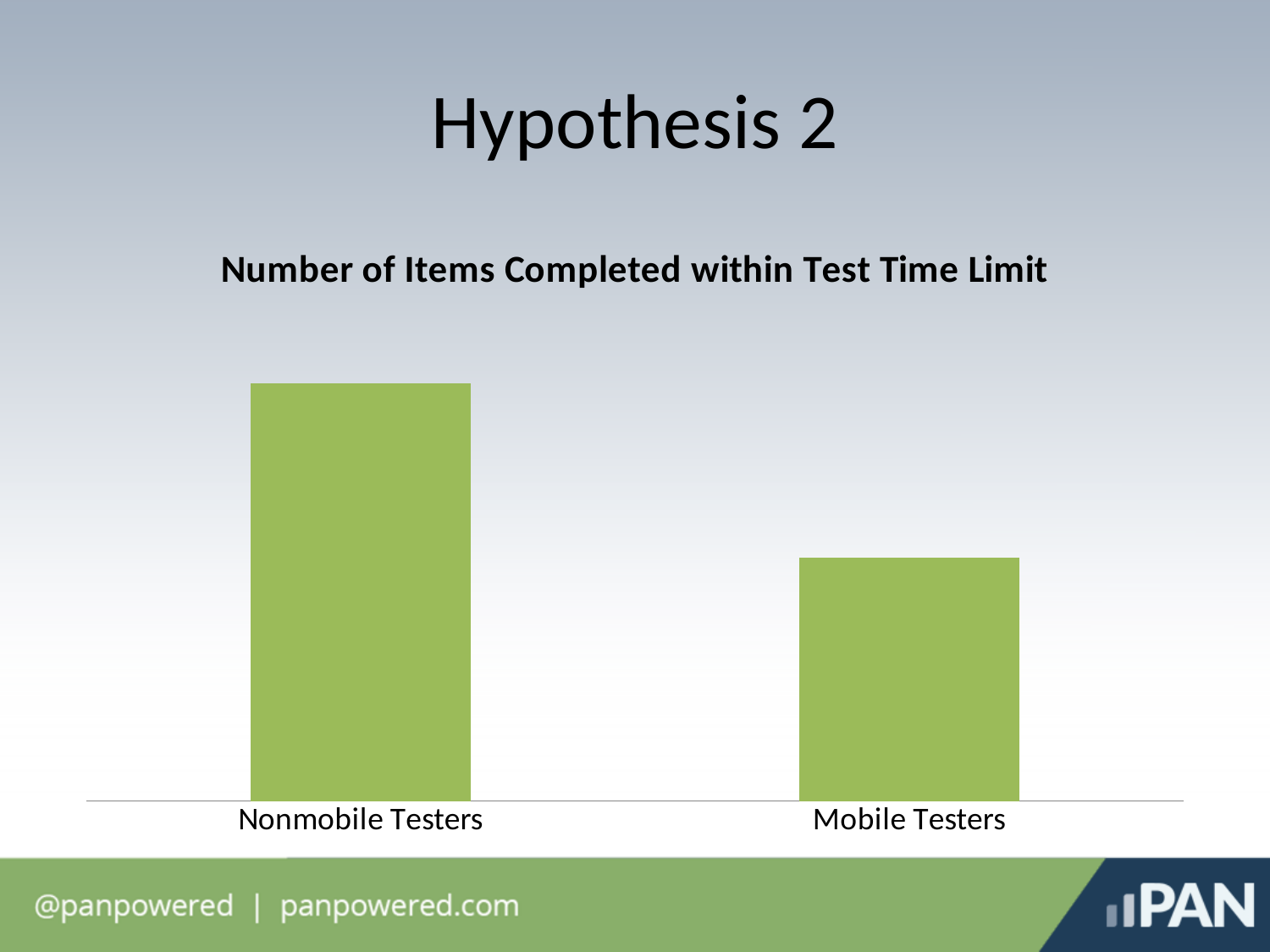
What are the two categories labelled on the x axis? Nonmobile Testers and Mobile Testers Which category has the highest value? Nonmobile Testers Which is larger, the value for Nonmobile Testers or the value for Mobile Testers? Nonmobile Testers Which category has the lowest value? Mobile Testers What kind of chart is shown on the slide? bar chart How many categories are shown in the chart? 2 What is the title of the chart? Number of Items Completed within Test Time Limit